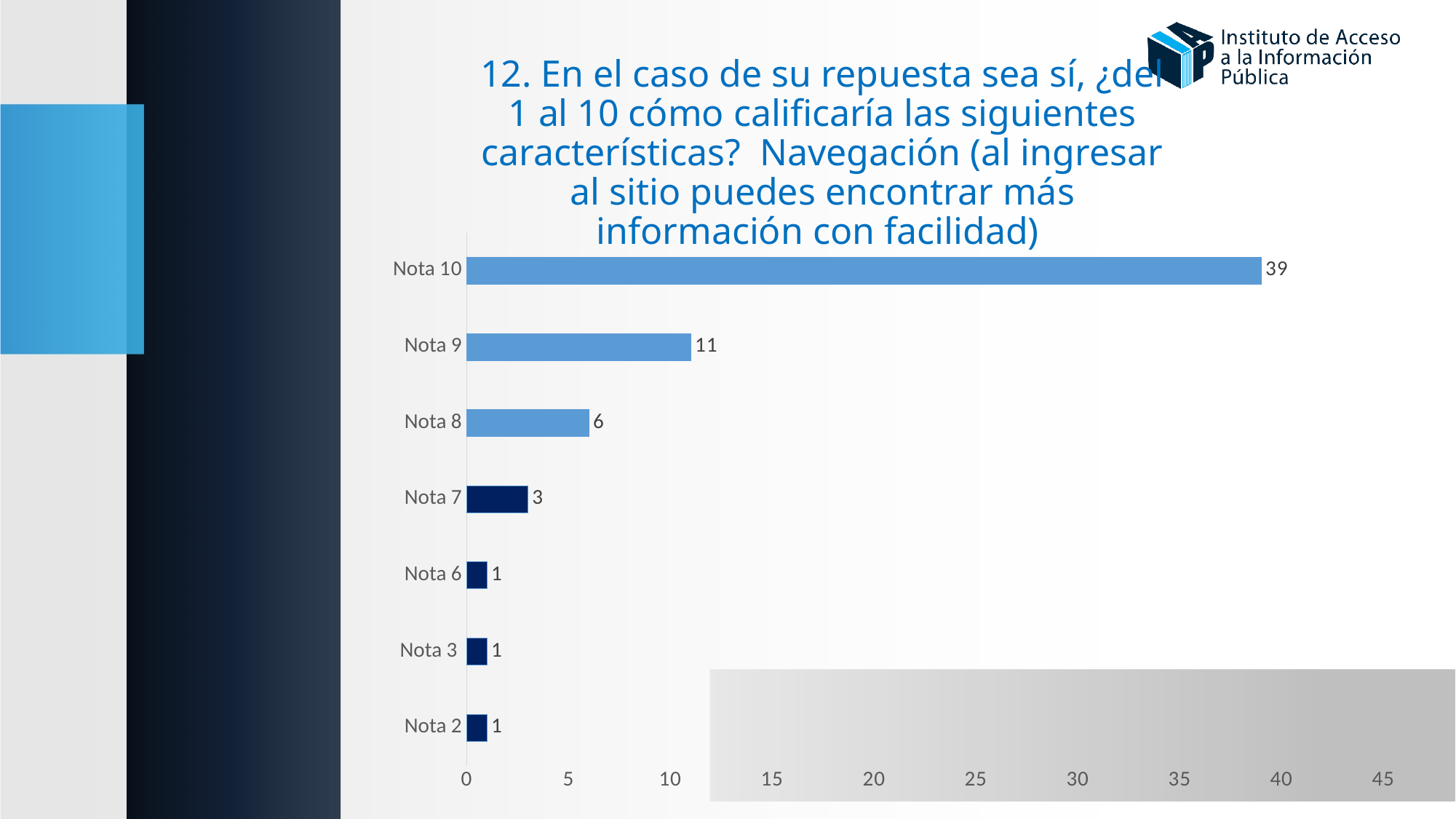
What is the value for Nota 10? 39 What is the value for Nota 9? 11 How many categories are shown in the chart? 7 What kind of chart is shown on the slide? bar chart Which category has the highest value? Nota 10 Which is larger, the value for Nota 8 or the value for Nota 7? Nota 8 What is the total of the values for Nota 6, Nota 3 and Nota 2? 3 What is the difference between the values for Nota 9 and Nota 8? 5 What is the value for Nota 7? 3 Is the value for Nota 10 greater or less than 35? greater What is the difference between the values for Nota 10 and Nota 9? 28 What is the value for Nota 8? 6